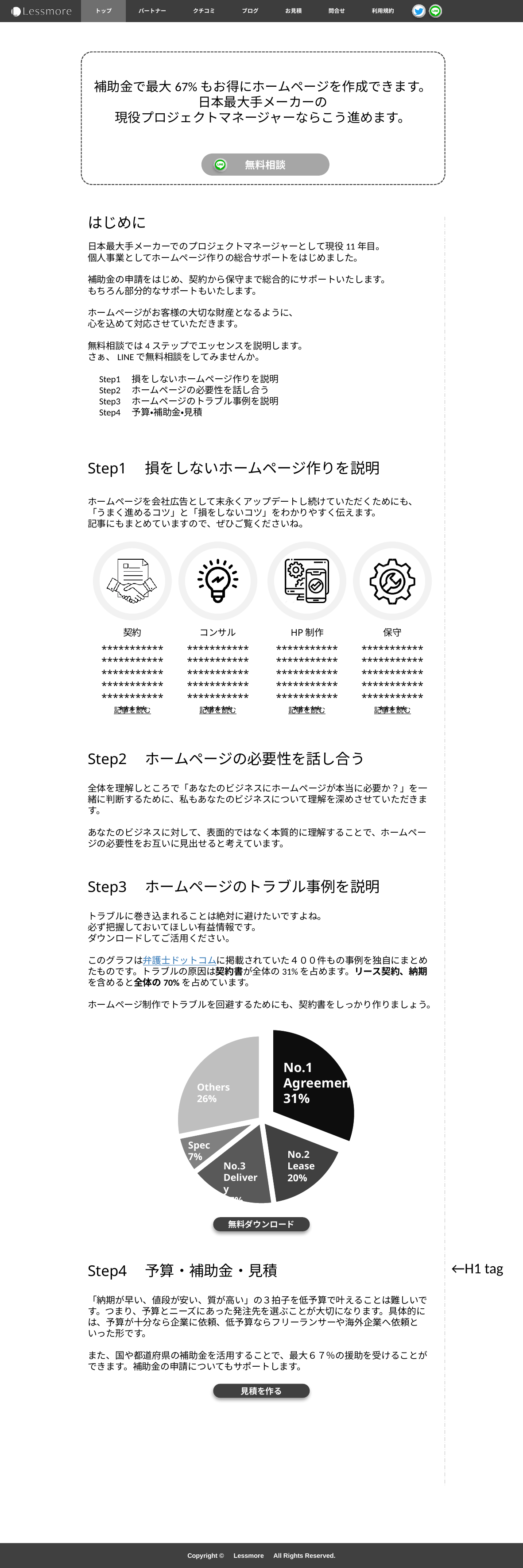
How many slices does the pie chart have? 5 What kind of chart is shown on the slide? pie chart Which slice of the pie chart is the smallest? Spec What share of the pie does the Others slice take? 26% What percentage is shown for the Spec slice? 7% What percentage is shown for the No.1 Agreement slice? 31% Which is larger, the No.1 Agreement slice or the Others slice? No.1 Agreement What colour is the No.1 Agreement slice? black What percentage is shown for the No.2 Lease slice? 20% What is the difference in percentage points between the No.1 Agreement slice and the No.2 Lease slice? 11 Which slice of the pie chart is the largest? No.1 Agreement Which is larger, the No.3 Delivery slice or the Spec slice? No.3 Delivery